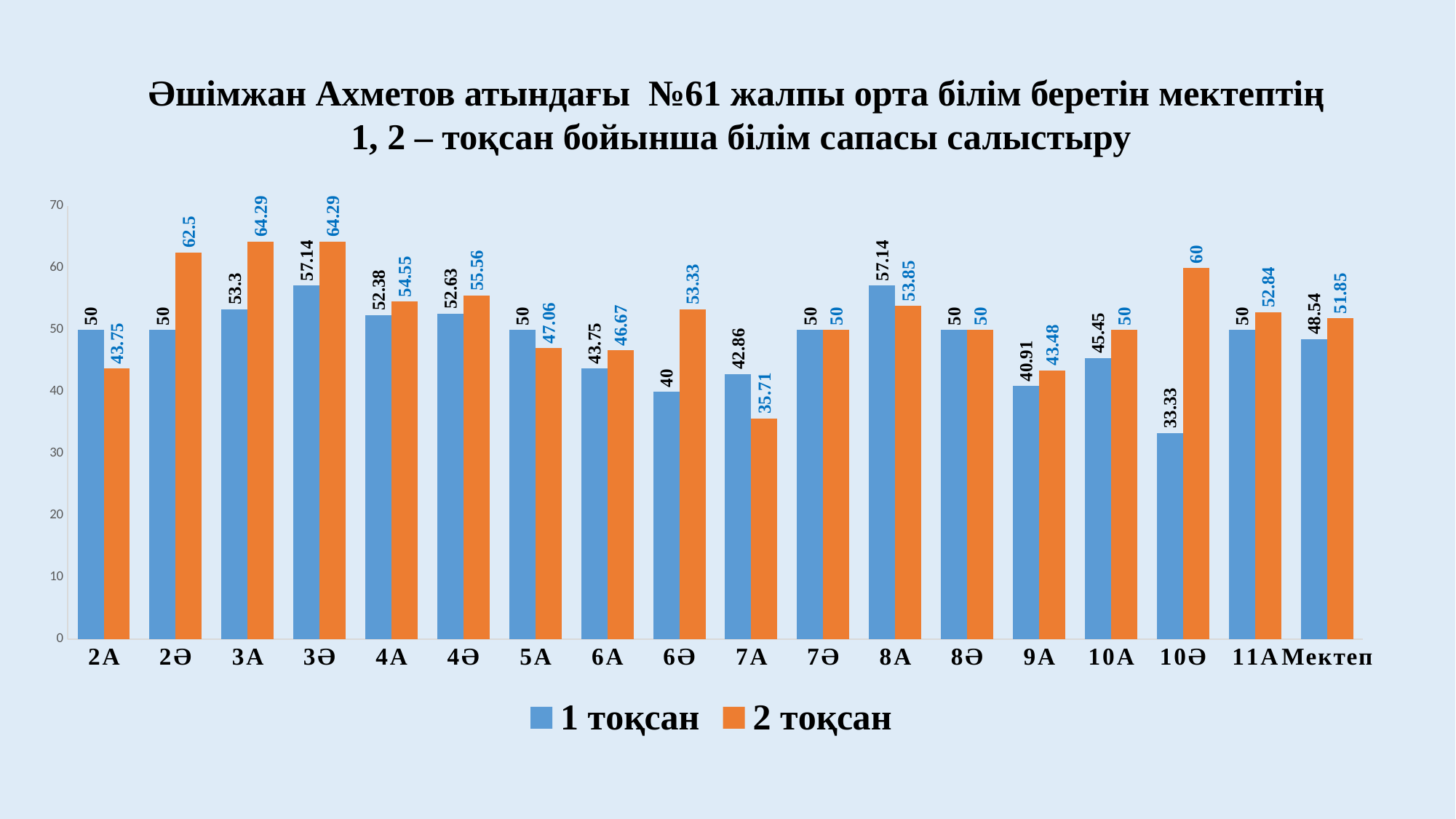
How many categories are shown on the x axis? 18 Is the 1 тоқсан value for 8А greater or less than 50? greater What is the difference between the 2 тоқсан and 1 тоқсан values for 10Ә? 26.67 How many series does the legend list? 2 What is the 2 тоқсан value for 2Ә? 62.5 What is the 2 тоқсан value for Мектеп? 51.85 For 6Ә, which series has the larger value, 1 тоқсан or 2 тоқсан? 2 тоқсан What kind of chart is shown on the slide? bar chart Which category has the lowest 2 тоқсан value? 7А What is the difference between the 2 тоқсан and 1 тоқсан values for 2Ә? 12.5 Which category has the lowest 1 тоқсан value? 10Ә What is the 1 тоқсан value for 10Ә? 33.33